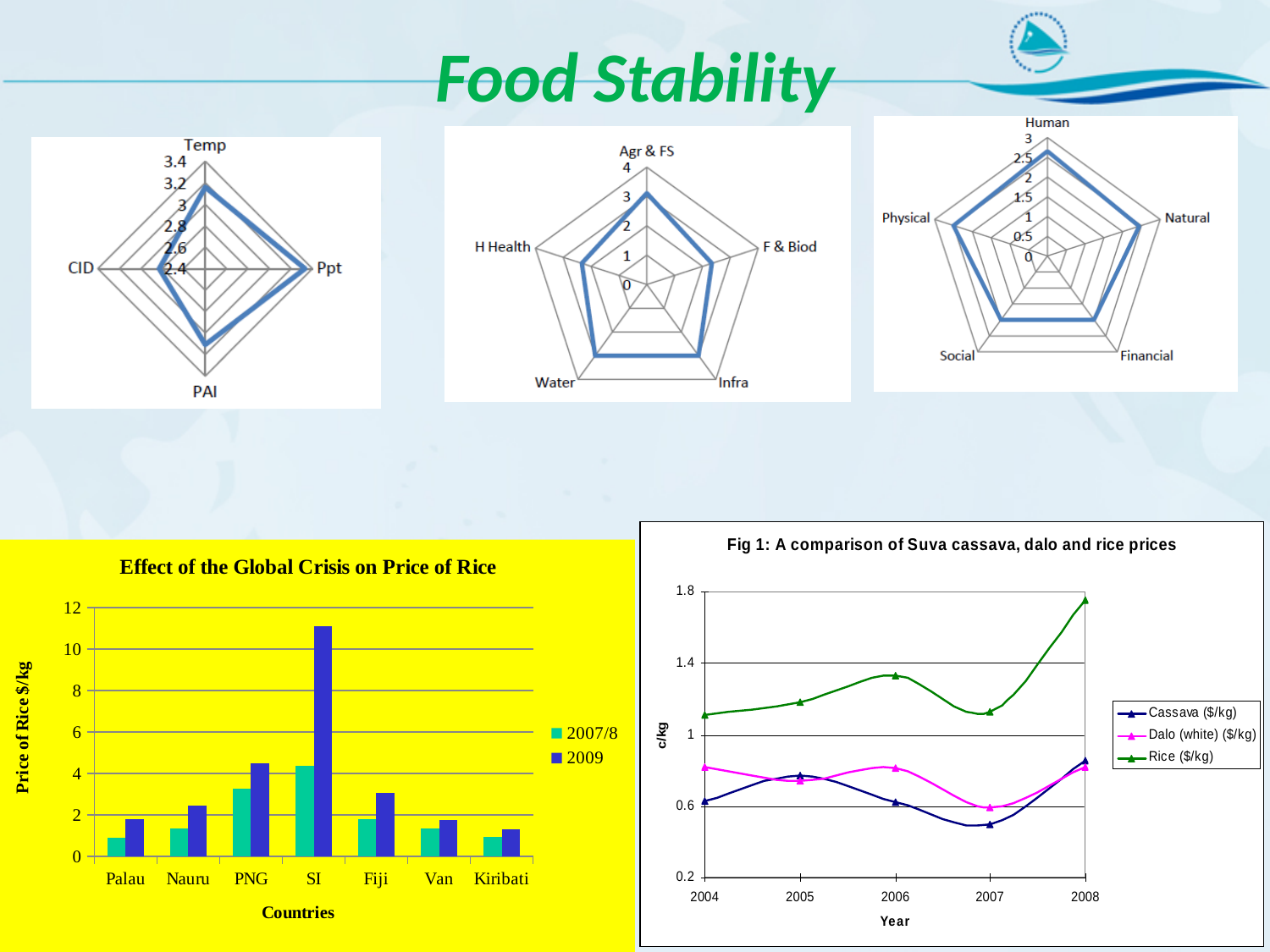
In the top-right radar chart with the axis Human, how many axes (categories) are there? 5 In the chart titled 'Effect of the Global Crisis on Price of Rice', which is larger: the 2009 value for Fiji or the 2009 value for Nauru? Fiji In the chart titled 'Effect of the Global Crisis on Price of Rice', is the 2009 value for SI greater or less than 10? greater In the chart titled 'Fig 1: A comparison of Suva cassava, dalo and rice prices', which series has the highest value in 2008? Rice ($/kg) In the chart titled 'Fig 1: A comparison of Suva cassava, dalo and rice prices', how many series does the legend list? 3 In the chart titled 'Effect of the Global Crisis on Price of Rice', which country has the highest bar? SI In the chart titled 'Effect of the Global Crisis on Price of Rice', is the 2009 value for PNG greater or less than 4? greater In the chart titled 'Fig 1: A comparison of Suva cassava, dalo and rice prices', is the Rice value in 2008 greater or less than 1.4? greater In the chart titled 'Fig 1: A comparison of Suva cassava, dalo and rice prices', does the Rice line rise or fall from 2007 to 2008? rise In the chart titled 'Effect of the Global Crisis on Price of Rice', how many countries are shown on the x axis? 7 What kind of chart is the top-left chart with the axes Temp, Ppt, PAI and CID? radar chart In the chart titled 'Effect of the Global Crisis on Price of Rice', how many series does the legend list? 2